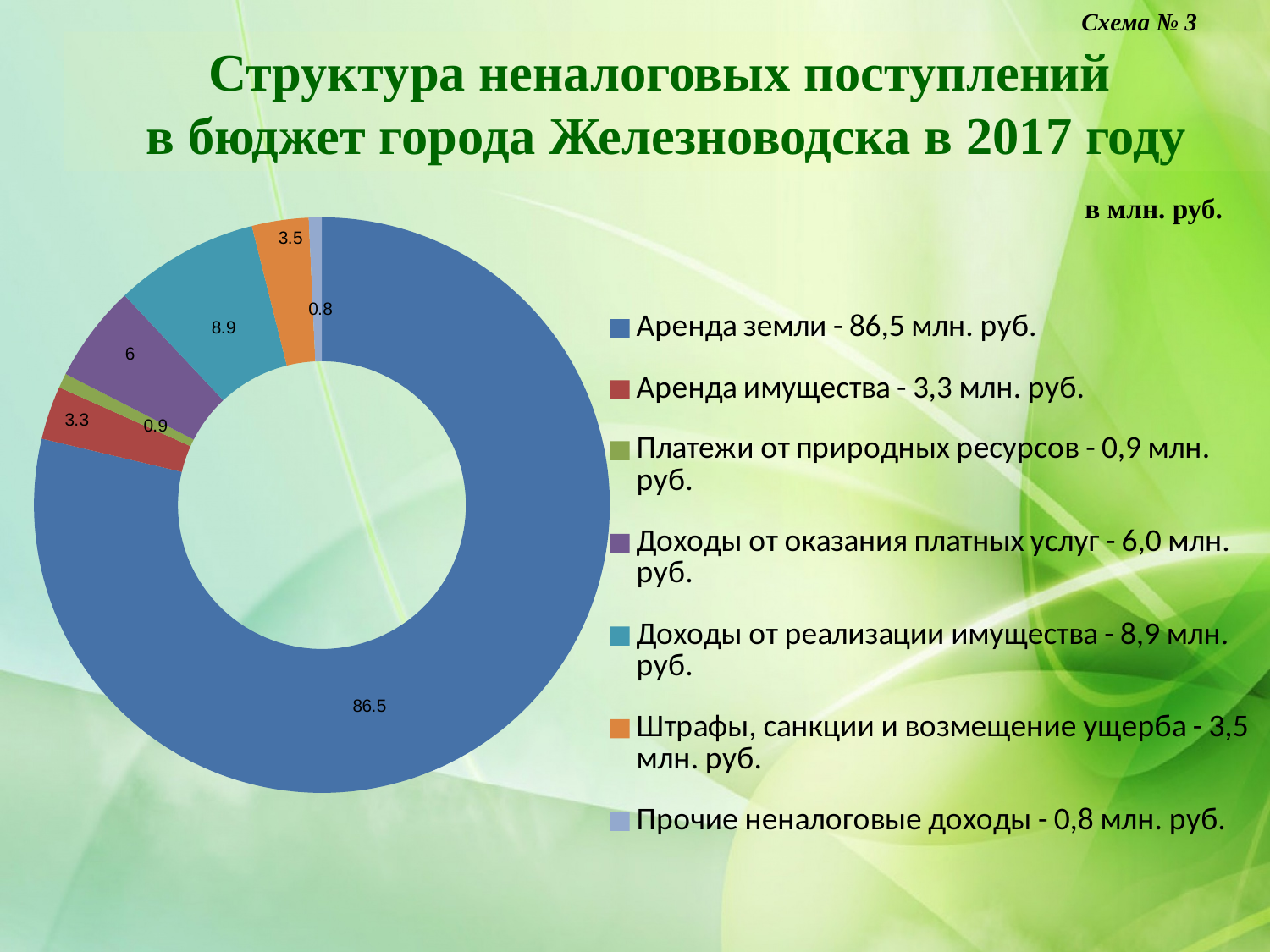
Which category has the largest slice? Аренда земли What is the value for Аренда земли? 86.5 How many categories does the chart show? 7 What is the value for Доходы от оказания платных услуг? 6 What is the difference between Аренда земли and Доходы от реализации имущества? 77.6 What is the value for Платежи от природных ресурсов? 0.9 What is the difference between Доходы от реализации имущества and Доходы от оказания платных услуг? 2.9 What kind of chart is shown on the slide? Doughnut (pie) chart Which is larger, Штрафы, санкции и возмещение ущерба or Аренда имущества? Штрафы, санкции и возмещение ущерба Which category has the smallest slice? Прочие неналоговые доходы In what units are the values on the chart given? млн. руб. What is the value for Доходы от реализации имущества? 8.9